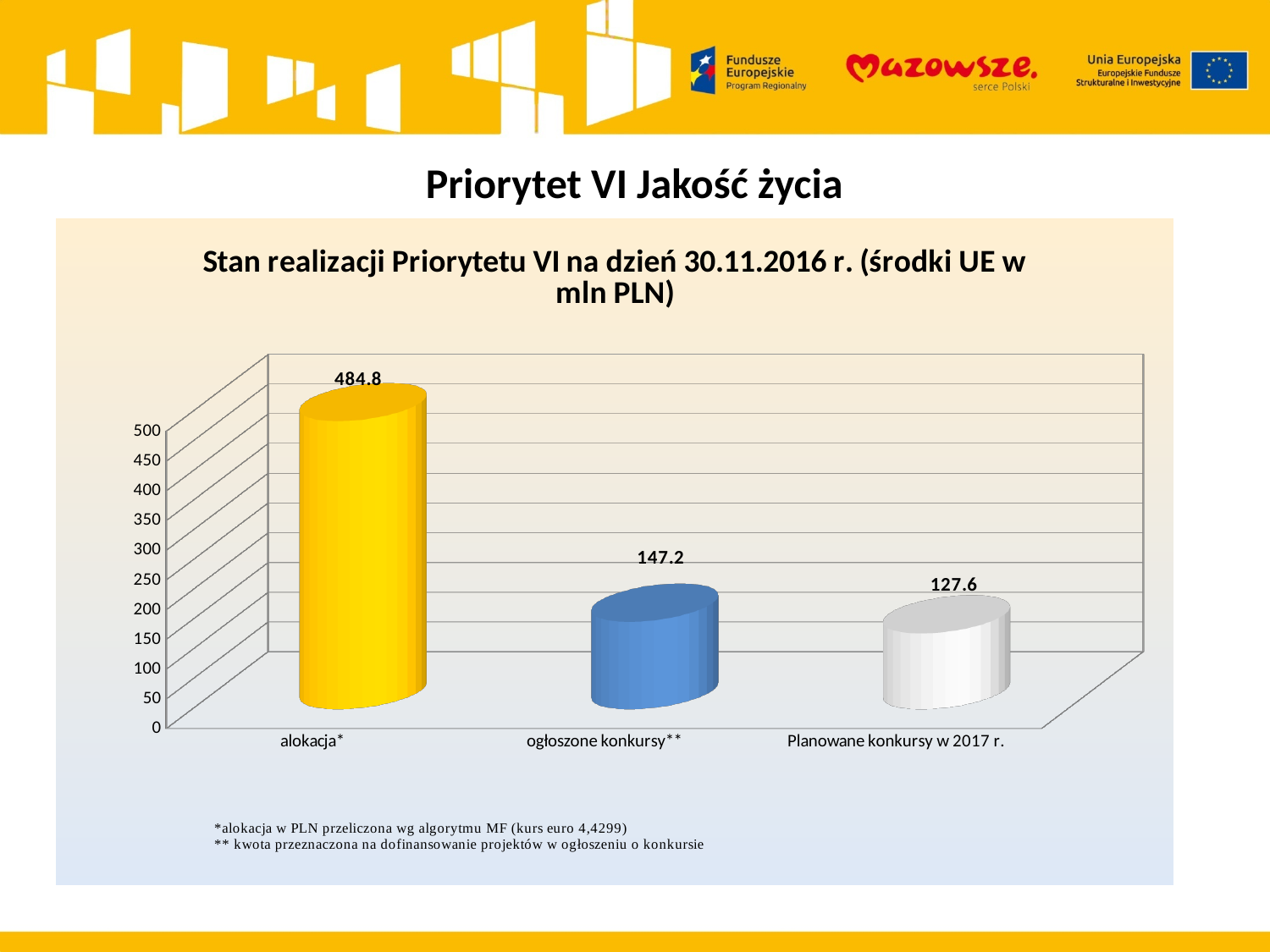
What is the title of the chart? Stan realizacji Priorytetu VI na dzień 30.11.2016 r. (środki UE w mln PLN) What is the difference between the values for alokacja* and ogłoszone konkursy**? 337.6 Is the value for alokacja* greater or less than 450? greater What is the value for Planowane konkursy w 2017 r.? 127.6 Which category has the lowest value? Planowane konkursy w 2017 r. What is the difference between the values for ogłoszone konkursy** and Planowane konkursy w 2017 r.? 19.6 What is the value for ogłoszone konkursy**? 147.2 Which is larger, the value for ogłoszone konkursy** or the value for Planowane konkursy w 2017 r.? ogłoszone konkursy** What is the value for alokacja*? 484.8 Which category has the highest value? alokacja* How many categories are shown on the chart? 3 What kind of chart is shown on the slide? bar chart